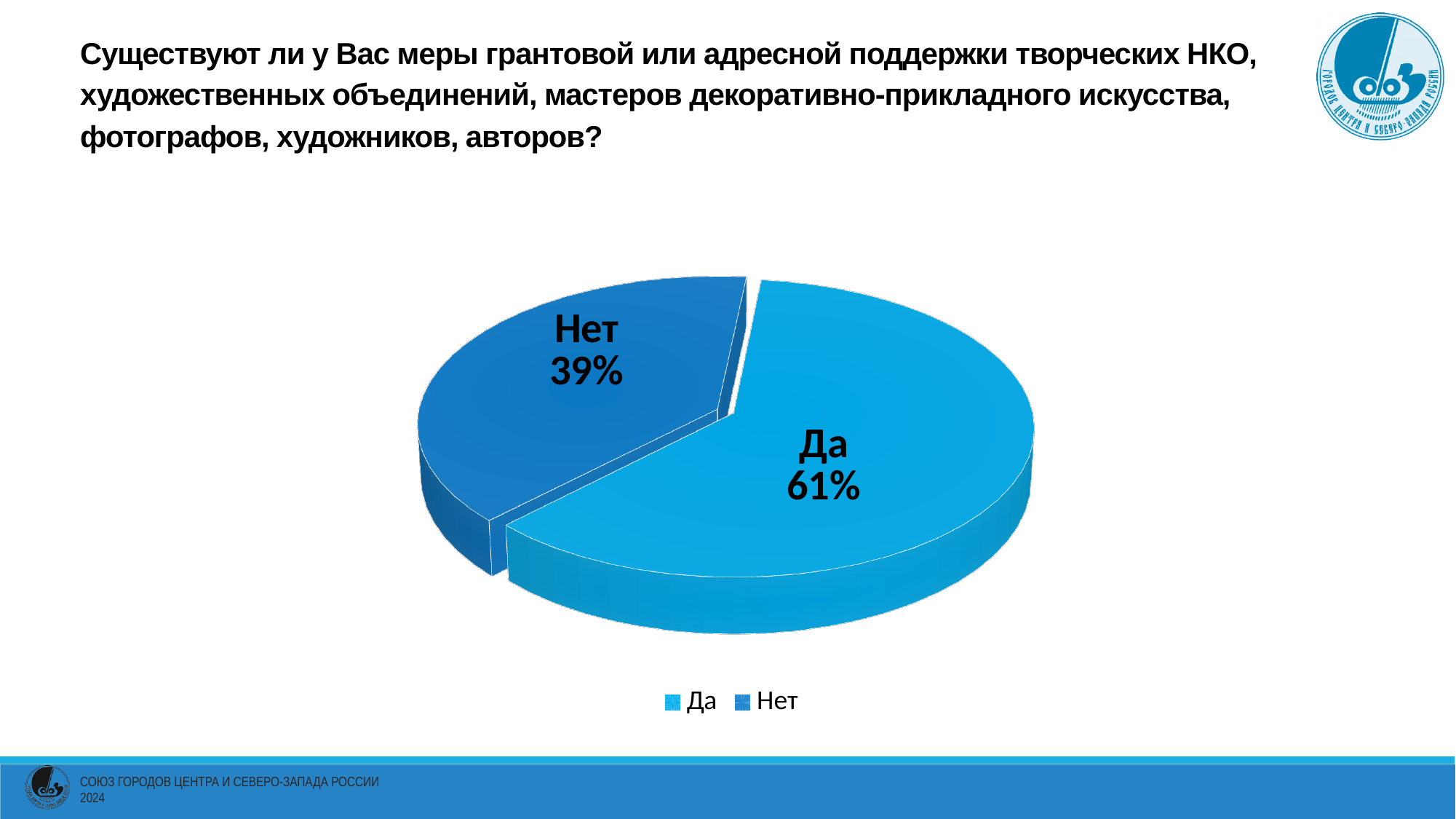
What share of the pie does the "Нет" slice represent? 39% How many slices does the pie chart have? 2 What share of the pie does the "Да" slice represent? 61% What is the total of the two slice percentages shown? 100% Which is larger, the "Да" slice or the "Нет" slice? Да Which legend entry appears first in the legend below the chart? Да What is the difference in percentage points between the "Да" and "Нет" slices? 22 Which legend entry is shown in the darker blue colour? Нет Which slice is the smallest in the pie chart? Нет How many entries does the legend list? 2 Which slice is the largest in the pie chart? Да What kind of chart is shown on the slide? Pie chart